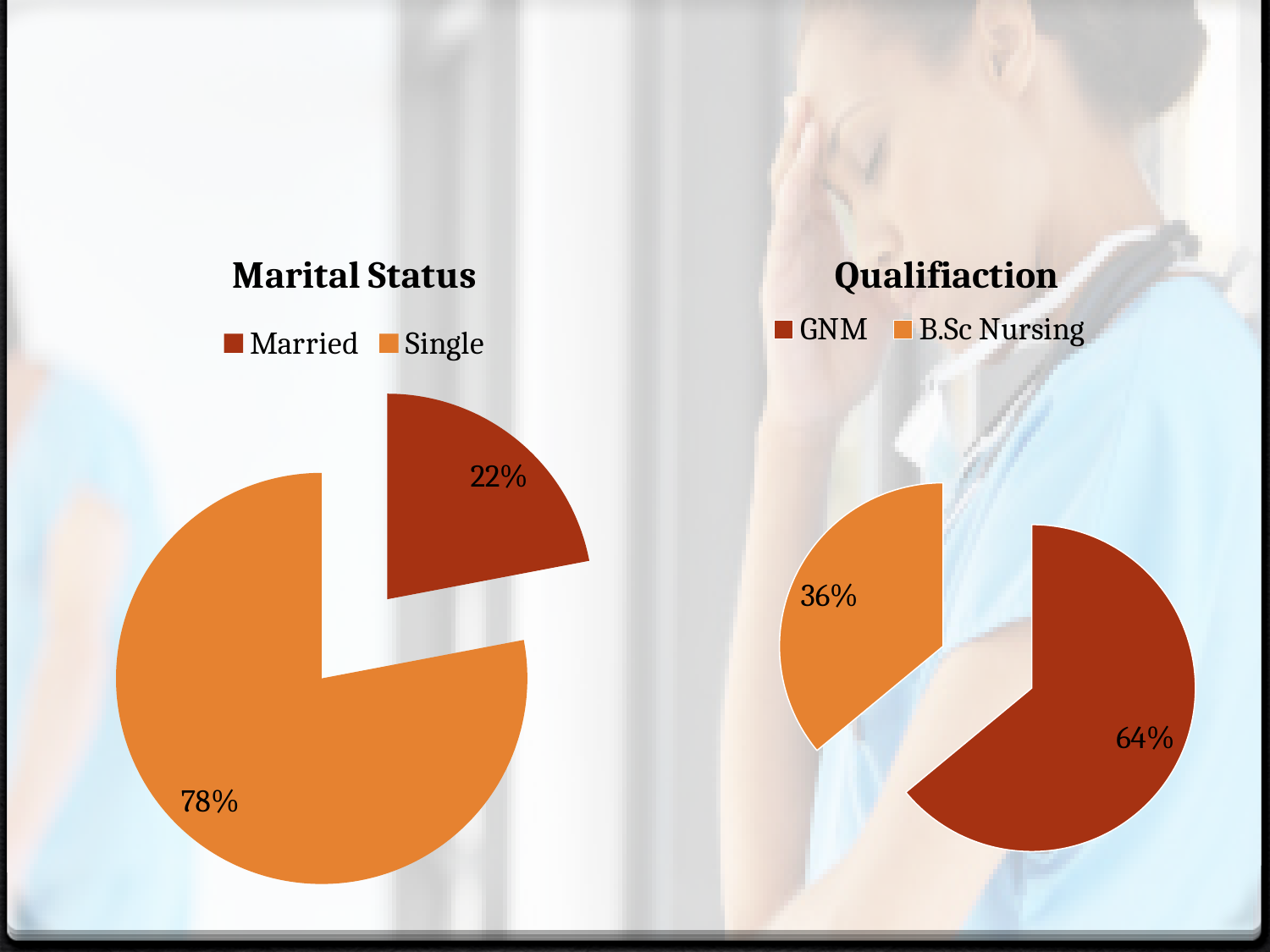
In the Marital Status chart, which category has the largest slice? Single In the Qualifiaction chart, what is the difference in percentage points between GNM and B.Sc Nursing? 28 In the Marital Status chart, what percentage is shown for Married? 22% In the Marital Status chart, what colour is the Single slice? Orange In the Qualifiaction chart, what percentage is shown for B.Sc Nursing? 36% What type of chart is the Marital Status chart? Pie chart In the Marital Status chart, what is the difference in percentage points between Single and Married? 56 In the Marital Status chart, what percentage is shown for Single? 78% In the Qualifiaction chart, which category has the smallest slice? B.Sc Nursing In the Qualifiaction chart, which is larger, GNM or B.Sc Nursing? GNM How many categories does the Qualifiaction chart's legend list? 2 In the Qualifiaction chart, what percentage is shown for GNM? 64%